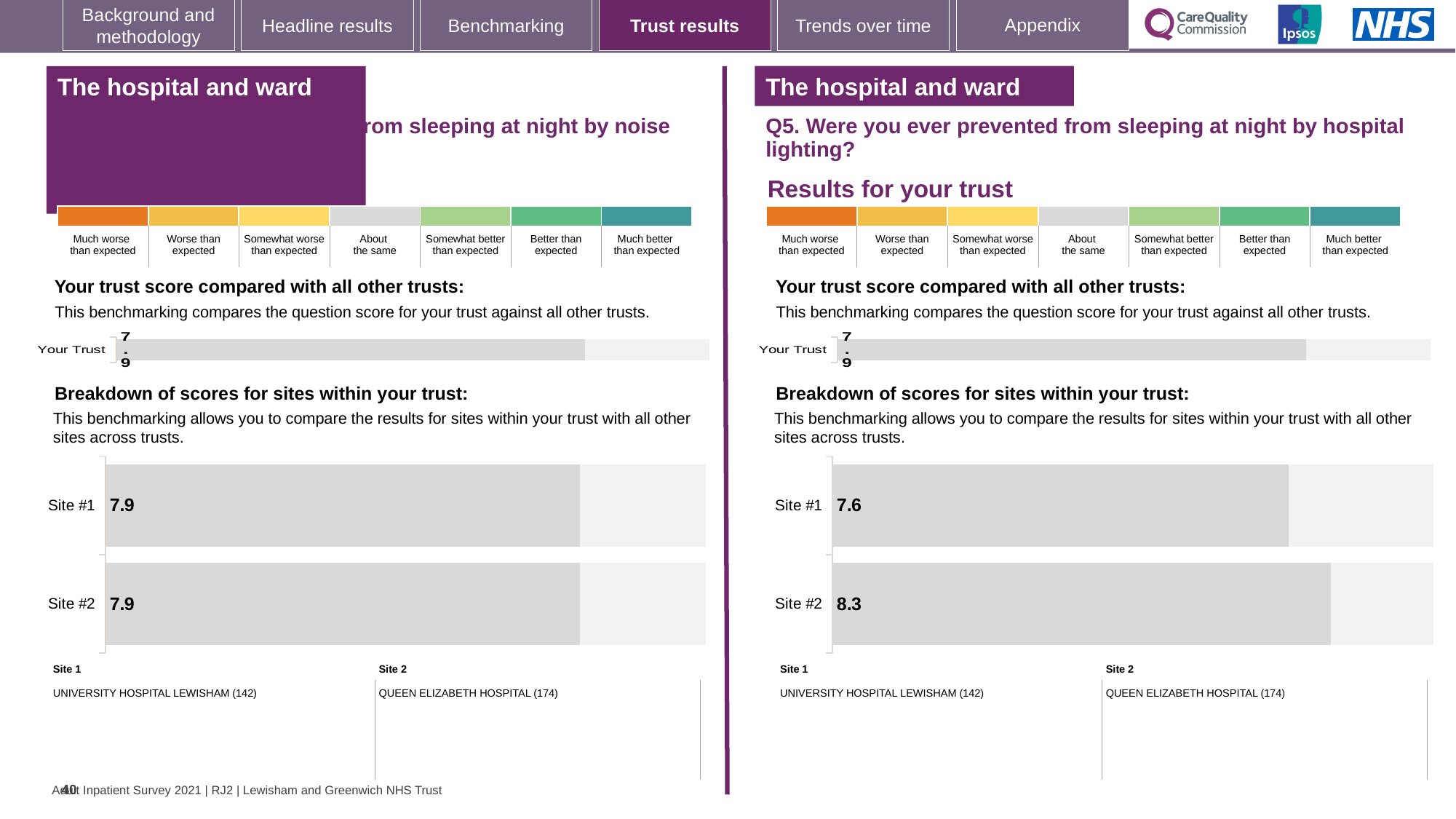
What type of chart is used for the breakdown of scores for sites on the right-hand slide? Bar chart On the right-hand slide (Q5, hospital lighting), what is the difference between the Site #2 and Site #1 scores? 0.7 On the right-hand slide (Q5, hospital lighting), which site has the higher score in the breakdown chart? Site #2 On the right-hand slide (Q5, hospital lighting), which site has the lower score in the breakdown chart? Site #1 On the right-hand slide (Q5, hospital lighting), what is the score for Site #2 in the breakdown of scores for sites within your trust? 8.3 How many categories are shown in the colour scale legend (from 'Much worse than expected' to 'Much better than expected') on the right-hand slide? 7 How many sites are shown in the breakdown chart on the right-hand slide (Q5, hospital lighting)? 2 On the right-hand slide (Q5, hospital lighting), what is the score for Site #1 in the breakdown of scores for sites within your trust? 7.6 On the left-hand slide (sleeping at night by noise), what is the score for Site #1 in the breakdown chart? 7.9 On the left-hand slide (sleeping at night by noise), what is the 'Your Trust' score in the trust comparison chart? 7.9 On the right-hand slide (Q5, hospital lighting), what is the 'Your Trust' score in the trust comparison chart? 7.9 On the left-hand slide (sleeping at night by noise), what is the score for Site #2 in the breakdown chart? 7.9